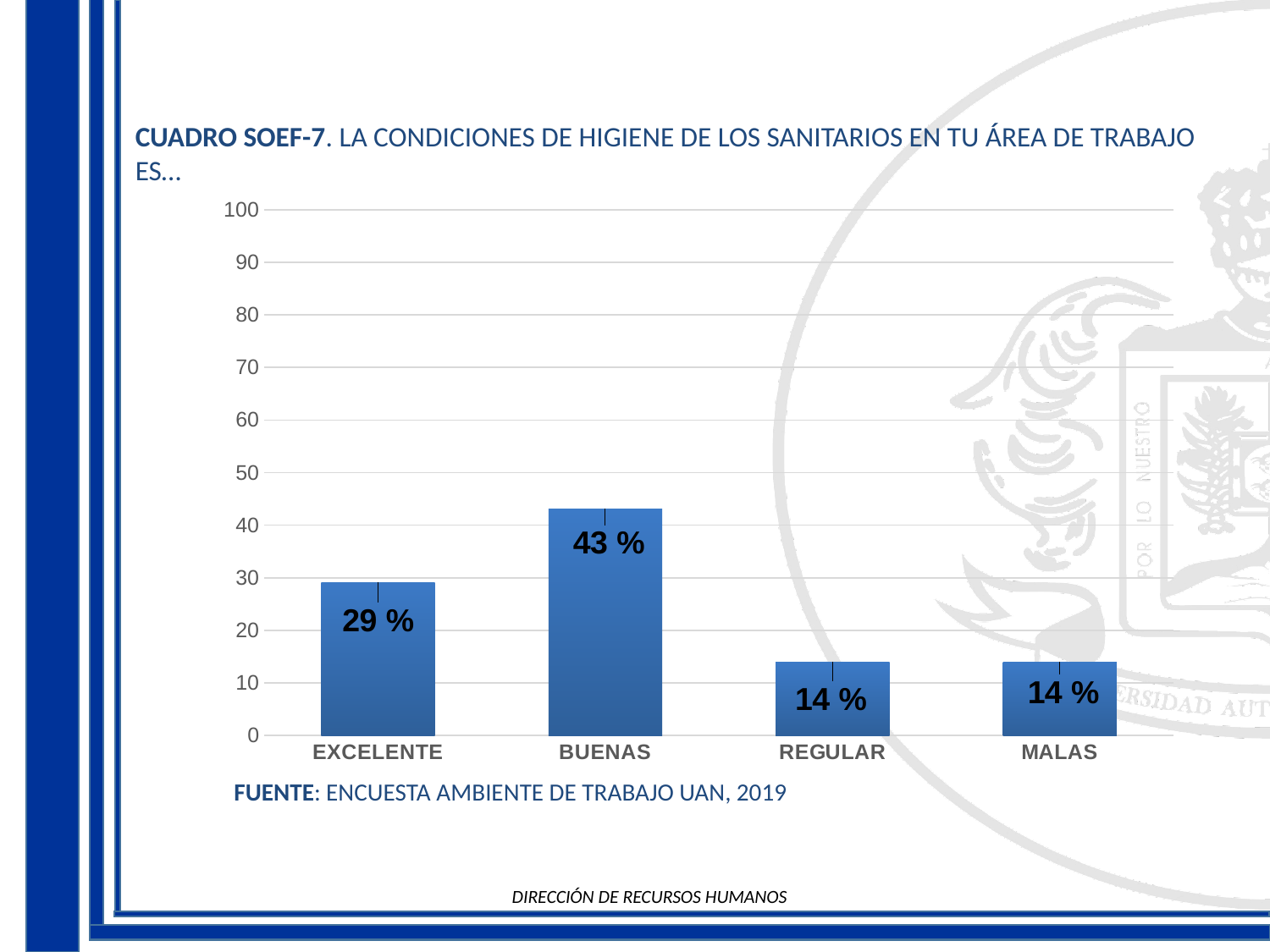
Which is larger, the value for EXCELENTE or the value for MALAS? EXCELENTE What is the difference between the values for BUENAS and EXCELENTE? 14 % How many categories are shown on the x axis? 4 What is the value for EXCELENTE? 29 % What source is cited below the chart? ENCUESTA AMBIENTE DE TRABAJO UAN, 2019 What is the difference between the values for EXCELENTE and REGULAR? 15 % What is the value for REGULAR? 14 % Which category has the highest value? BUENAS Is the value for BUENAS greater or less than 40? greater What is the value for BUENAS? 43 % What kind of chart is shown on the slide? bar chart Is the value for MALAS greater or less than 20? less